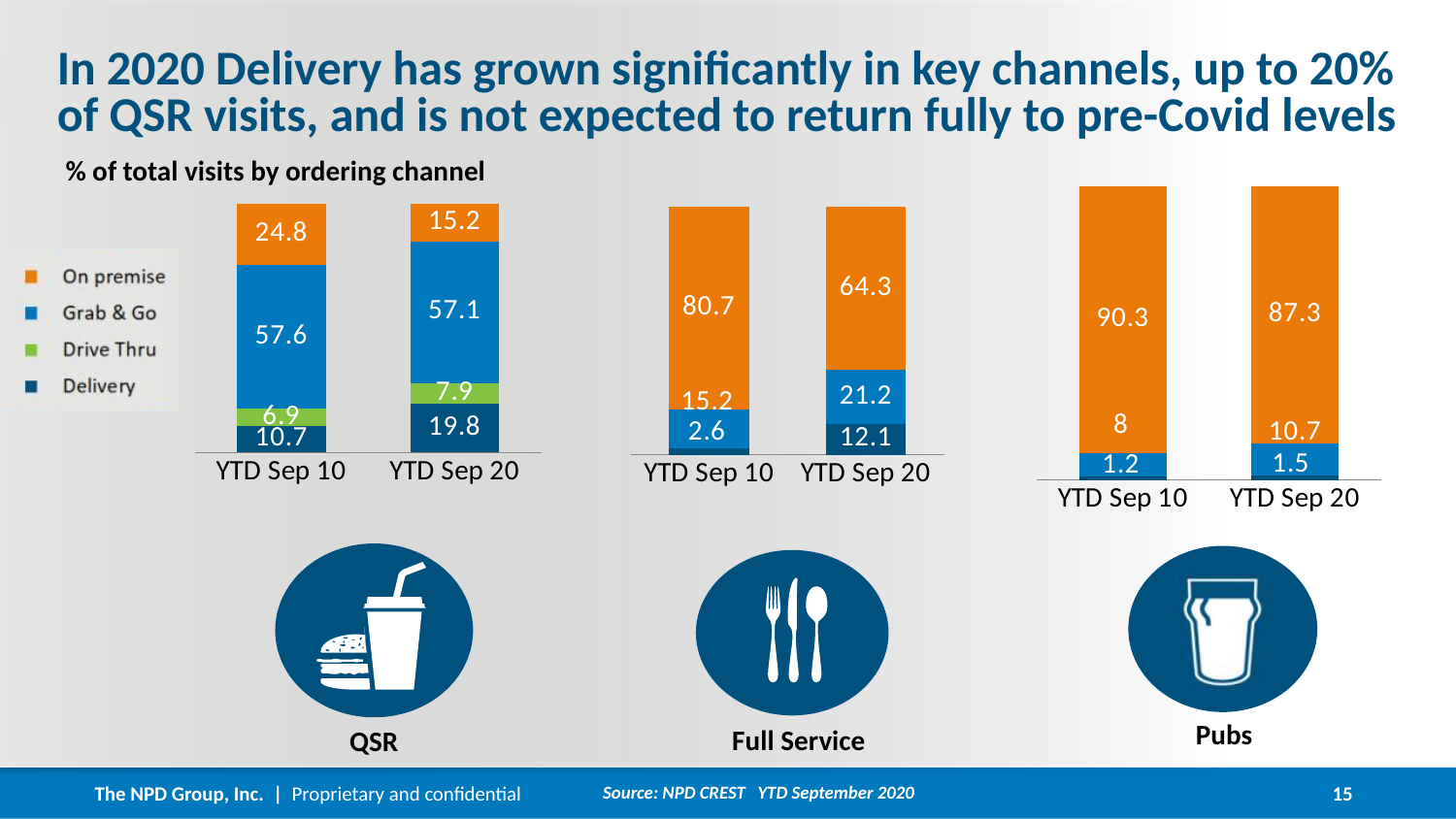
In the Full Service chart, what is the difference in the Delivery value between YTD Sep 20 and YTD Sep 10? 9.5 What kind of chart is used for the QSR data? Stacked bar chart How many series does the legend list? 4 In the Full Service chart, what is the On premise value for YTD Sep 10? 80.7 In the Pubs chart, which segment is the smallest in the YTD Sep 10 bar? Delivery Which colour represents On premise in the legend? Orange In the QSR chart, what is the Delivery value for YTD Sep 20? 19.8 In the Pubs chart, what is the Grab & Go value for YTD Sep 20? 10.7 In the Pubs chart, does the On premise value rise or fall from YTD Sep 10 to YTD Sep 20? fall In the QSR chart, which segment is the largest in the YTD Sep 20 bar? Grab & Go In the Full Service chart, what is the total of the YTD Sep 20 stacked bar? 97.6 In the QSR chart, which is larger: the On premise value for YTD Sep 10 or for YTD Sep 20? YTD Sep 10